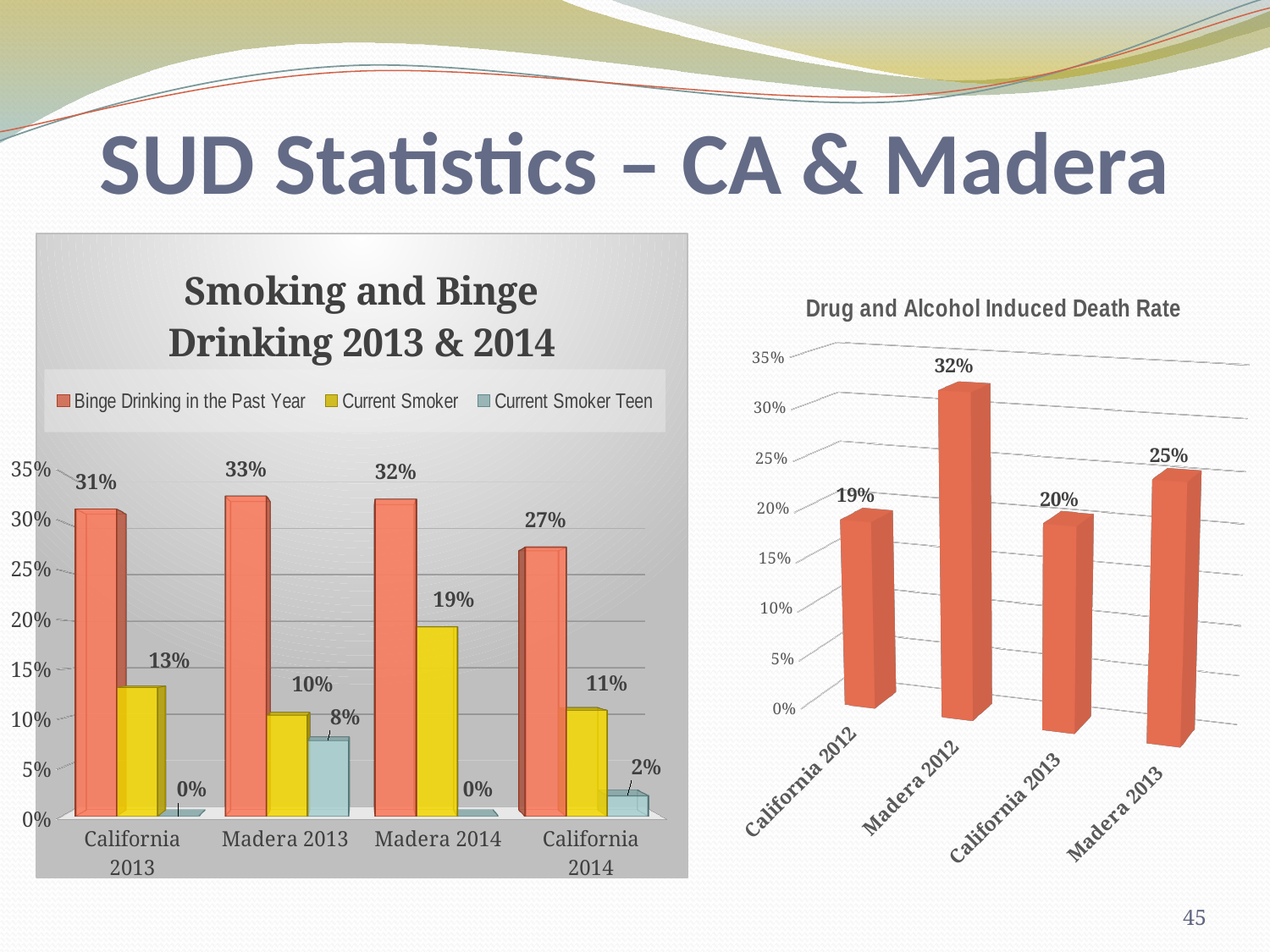
What kind of chart is the 'Drug and Alcohol Induced Death Rate' chart? Bar chart In the 'Drug and Alcohol Induced Death Rate' chart, what is the difference between Madera 2013 and California 2013? 5% In the 'Smoking and Binge Drinking 2013 & 2014' chart, what is the Current Smoker Teen value for Madera 2013? 8% In the 'Drug and Alcohol Induced Death Rate' chart, what is the value for Madera 2012? 32% In the 'Smoking and Binge Drinking 2013 & 2014' chart, what is the difference between the Current Smoker values for Madera 2014 and Madera 2013? 9% In the 'Smoking and Binge Drinking 2013 & 2014' chart, what is the Current Smoker value for Madera 2014? 19% In the 'Smoking and Binge Drinking 2013 & 2014' chart, is the Current Smoker value for California 2013 larger than the Current Smoker value for California 2014? Yes In the 'Smoking and Binge Drinking 2013 & 2014' chart, what is the Binge Drinking in the Past Year value for Madera 2013? 33% In the 'Smoking and Binge Drinking 2013 & 2014' chart, which category has the lowest Binge Drinking in the Past Year value? California 2014 In the 'Smoking and Binge Drinking 2013 & 2014' chart, how many series does the legend list? 3 In the 'Drug and Alcohol Induced Death Rate' chart, how many categories are shown? 4 In the 'Drug and Alcohol Induced Death Rate' chart, which category has the lowest value? California 2012